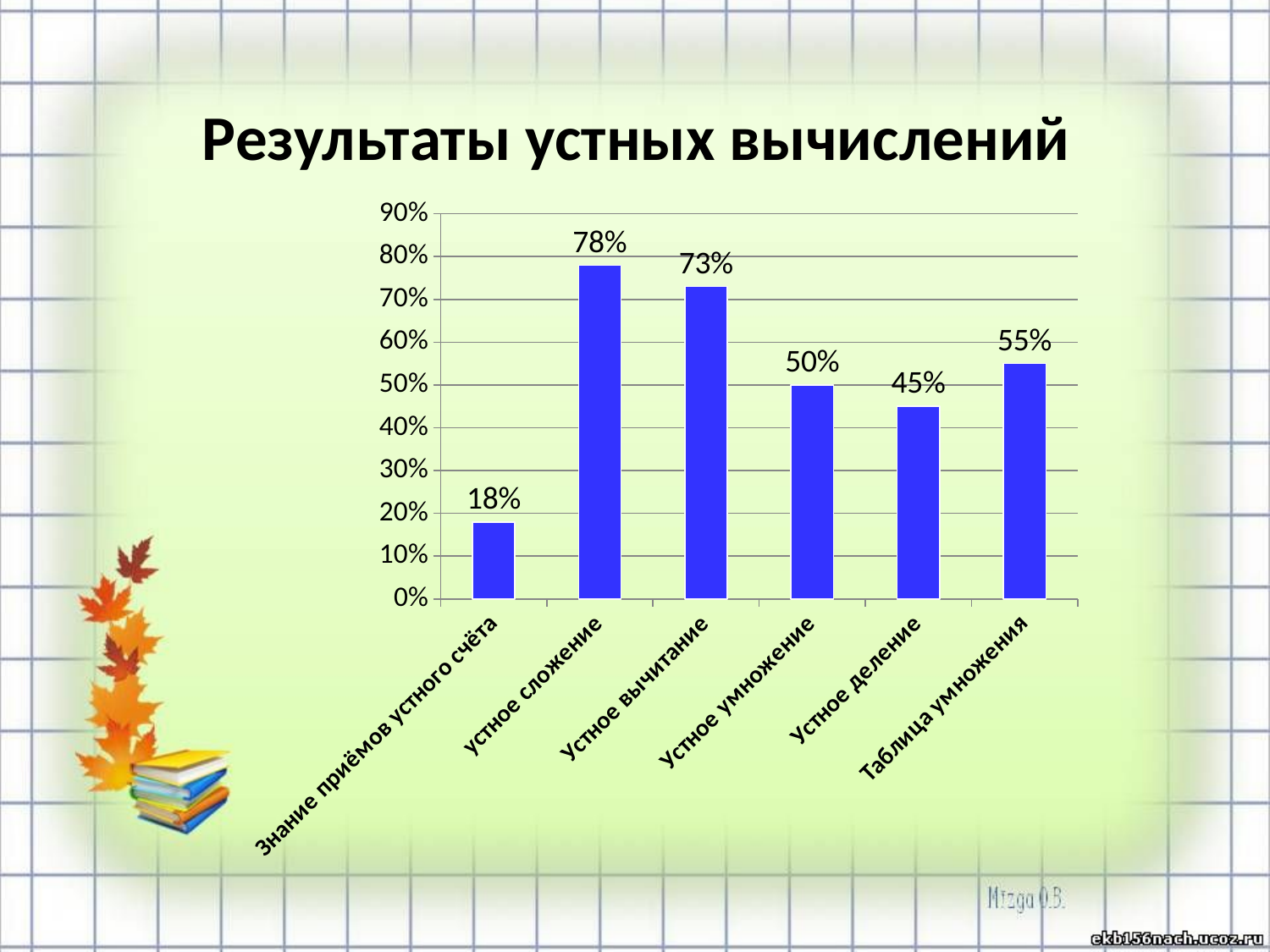
Is the value for Устное вычитание greater or less than 70%? greater Which category has the lowest value? Знание приёмов устного счёта Which is larger, the value for Устное умножение or the value for Устное деление? Устное умножение Which category has the highest value? Устное сложение What kind of chart is shown on the slide? bar chart What is the difference between the values for Таблица умножения and Устное деление? 10% How many categories are shown on the x axis? 6 What is the value for Устное сложение? 78% What is the value for Знание приёмов устного счёта? 18% What is the title of the slide? Результаты устных вычислений What is the value for Таблица умножения? 55% What is the difference between the values for Устное сложение and Устное вычитание? 5%